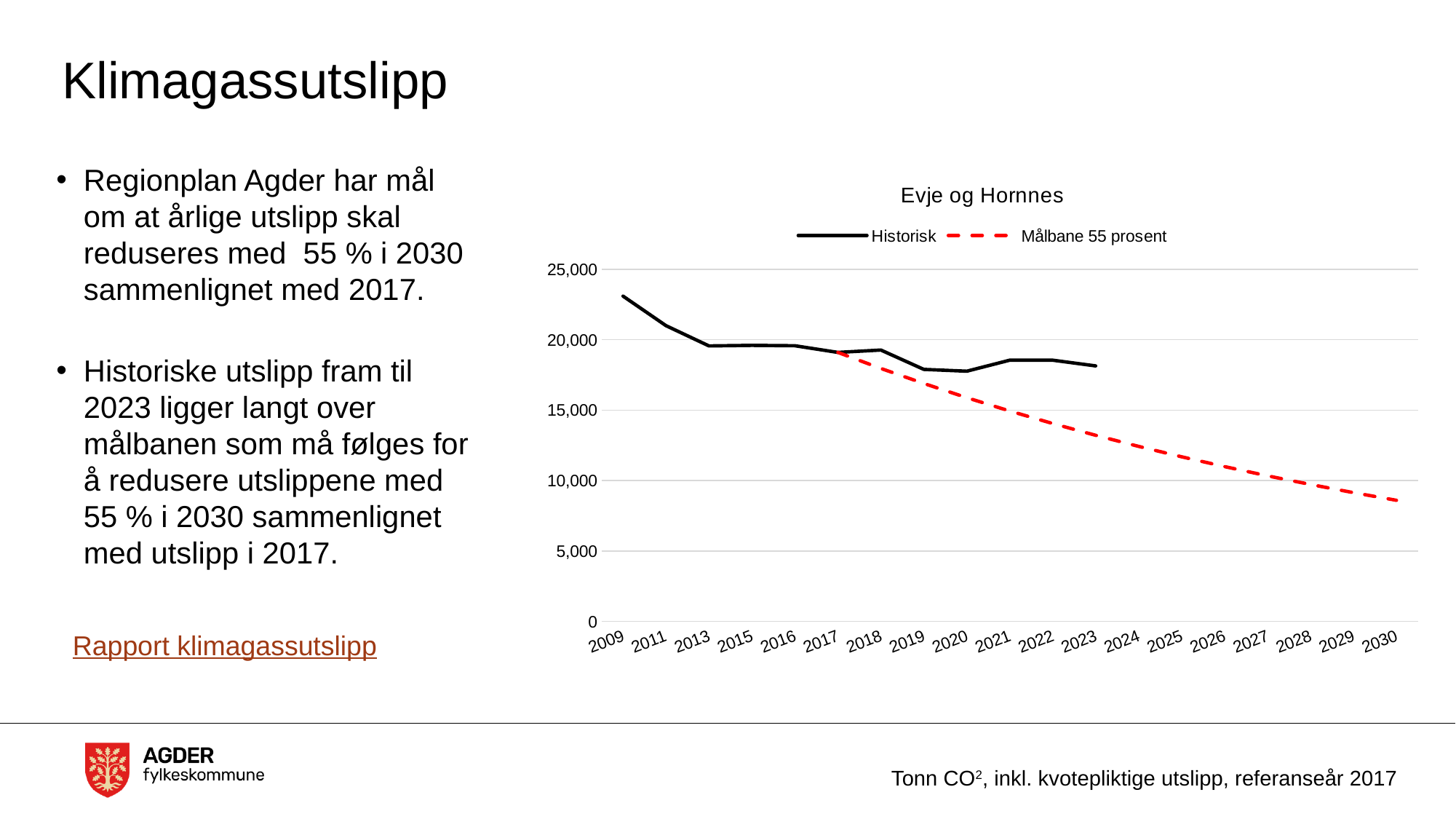
What kind of chart is shown on the slide? Line chart What is the title of the chart? Evje og Hornnes How many years are labelled on the x axis of the chart? 19 In 2023, which is larger: the Historisk value or the Målbane 55 prosent value? Historisk How many series does the chart legend list? 2 Does the Historisk series generally rise or fall from 2009 to 2023? Fall In which year is the Historisk series at its highest? 2009 Which series is drawn as a red dashed line? Målbane 55 prosent Does the Målbane 55 prosent series rise or fall from 2017 to 2030? Fall In which year is the Målbane 55 prosent series at its lowest? 2030 Is the Historisk value for 2009 greater or less than 20,000? greater Is the Målbane 55 prosent value for 2030 greater or less than 10,000? less